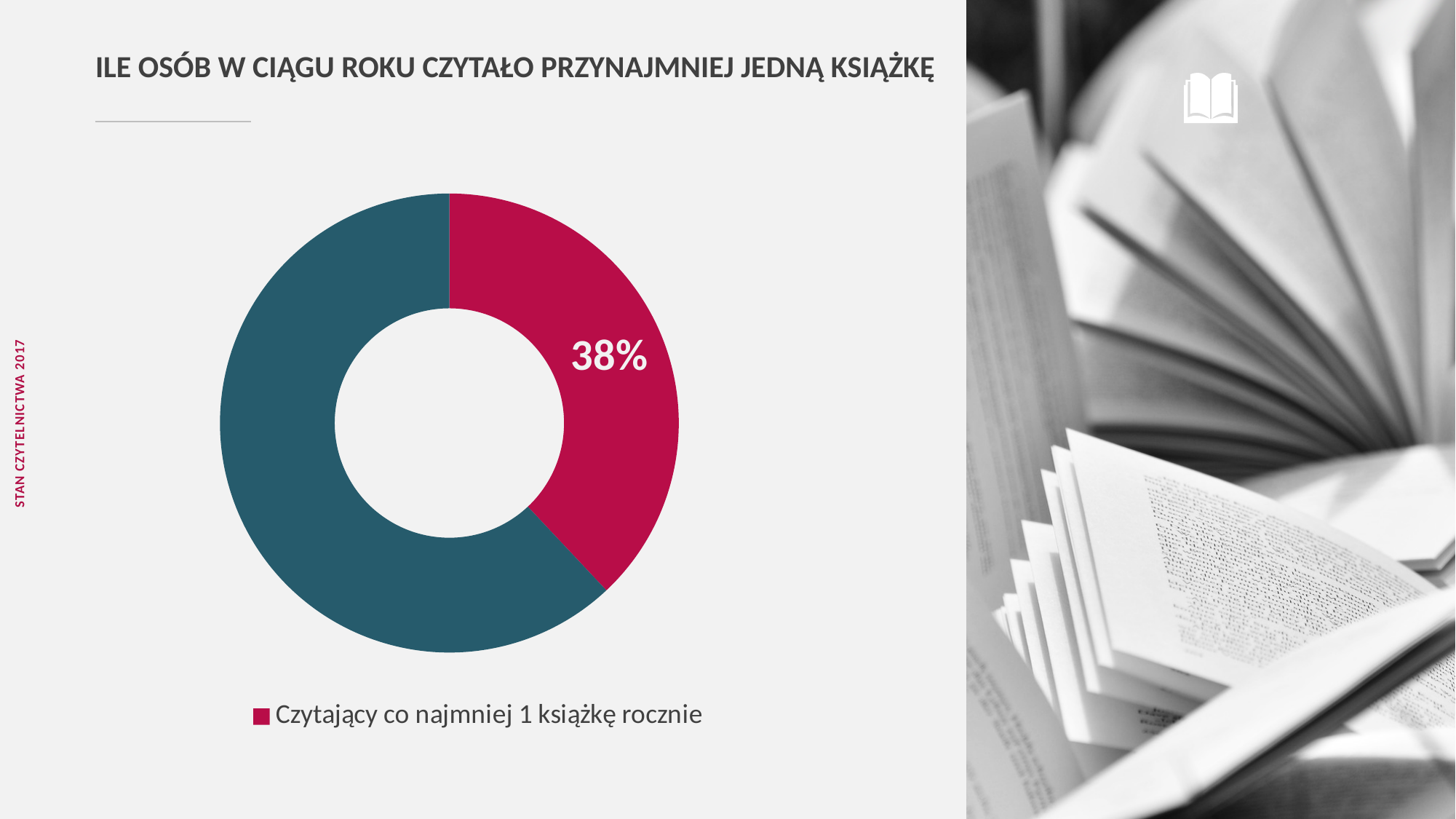
Is the unlabeled teal slice greater or less than 50% of the donut? greater What colour is the slice labelled 38%? Magenta (crimson) How many slices does the donut chart have? 2 What kind of chart is shown on the slide? Pie (donut) chart What share of the donut does the "Czytający co najmniej 1 książkę rocznie" slice represent? 38% How many entries does the chart legend list? 1 What is the title of the chart on the slide? ILE OSÓB W CIĄGU ROKU CZYTAŁO PRZYNAJMNIEJ JEDNĄ KSIĄŻKĘ What percentage is shown for "Czytający co najmniej 1 książkę rocznie"? 38% Which slice is the largest in the donut chart? The unlabeled teal slice Is the slice for "Czytający co najmniej 1 książkę rocznie" larger or smaller than the other slice? smaller